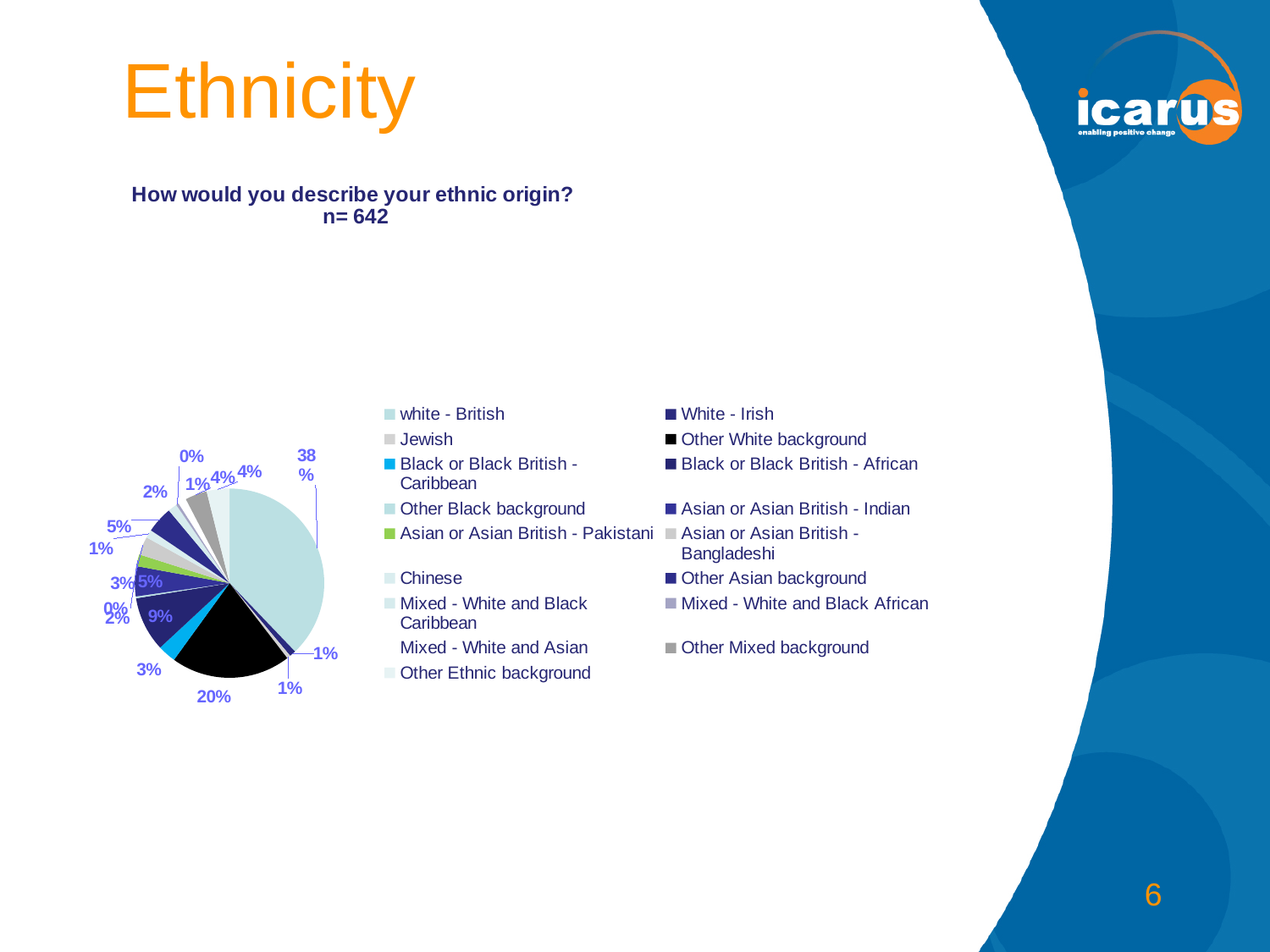
Is the white - British slice greater or less than 25% of the pie? greater What is the difference between the largest slice (38%) and the second largest slice (20%)? 18% What is the smallest percentage value labelled on the pie? 0% What is the title of the chart? How would you describe your ethnic origin? n= 642 What share of the pie does the white - British slice represent? 38% How many categories does the chart legend list? 17 What kind of chart is shown on the slide? pie chart What is the second largest percentage labelled on the pie? 20% Which category has the largest slice of the pie? white - British What sample size (n) is stated in the chart title? 642 What percentage is shown for white - British? 38% How many slices are labelled 0%? 2